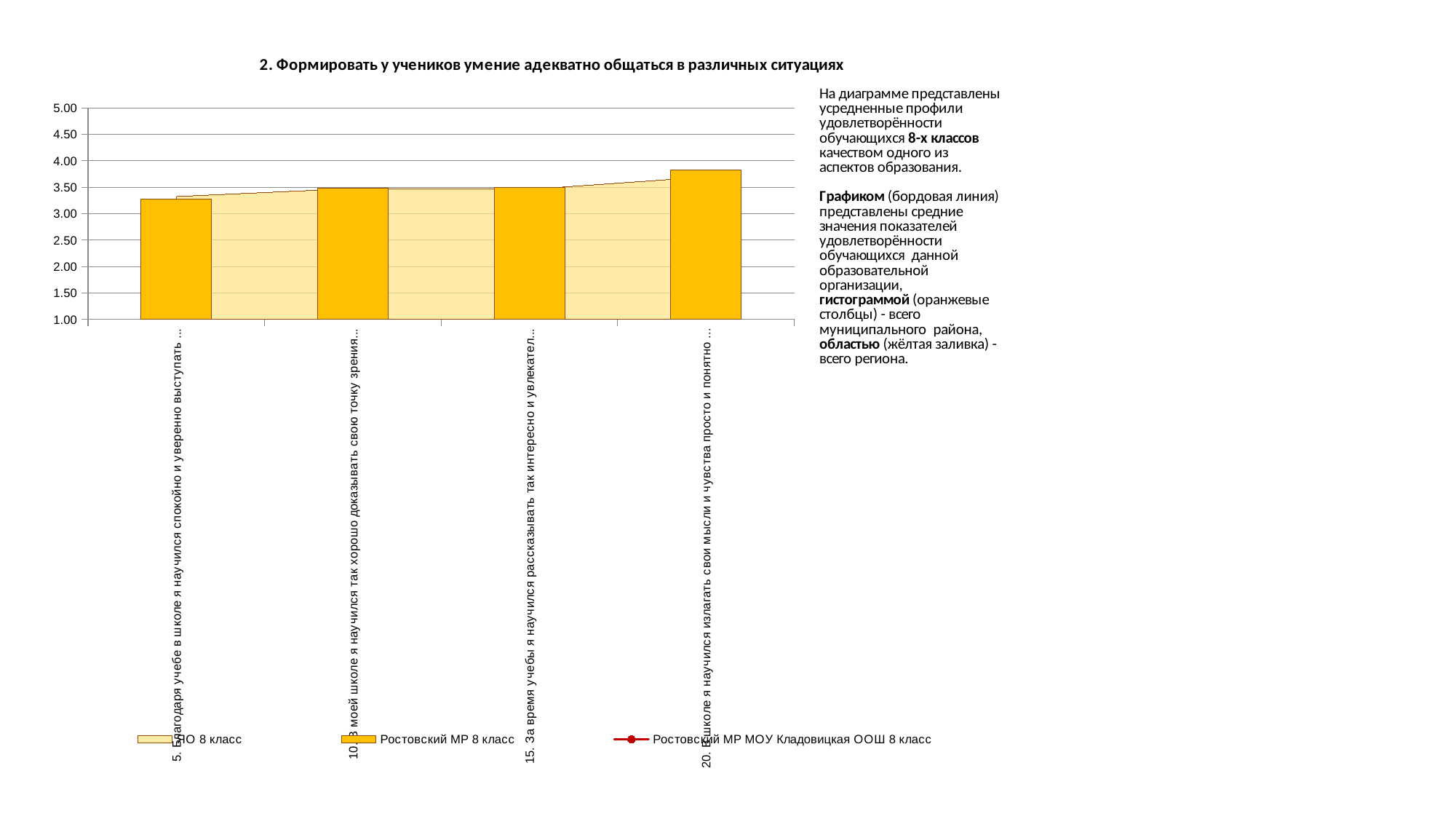
Which category has the lowest orange bar (Ростовский МР 8 класс)? 5. Благодаря учебе в школе я научился спокойно и уверенно выступать Is the Ростовский МР 8 класс value for category 20 greater or less than 4.00? less How many series does the chart legend list? 3 Is the Ростовский МР 8 класс value for category 20 (В школе я научился излагать свои мысли...) greater or less than 3.50? greater Which is larger for Ростовский МР 8 класс: the value for category 5 or the value for category 20? category 20 Do the orange bars (Ростовский МР 8 класс) generally rise or fall from left to right along the x axis? rise What is the title of the chart? 2. Формировать у учеников умение адекватно общаться в различных ситуациях Which series is shown with the yellow area fill according to the legend? ЯО 8 класс What kind of chart is shown on the slide? bar chart with an area series Is the Ростовский МР 8 класс value for category 5 (Благодаря учебе в школе я научился спокойно...) greater or less than 3.50? less How many categories are shown along the x axis of the chart? 4 Which category has the highest orange bar (Ростовский МР 8 класс)? 20. В школе я научился излагать свои мысли и чувства просто и понятно